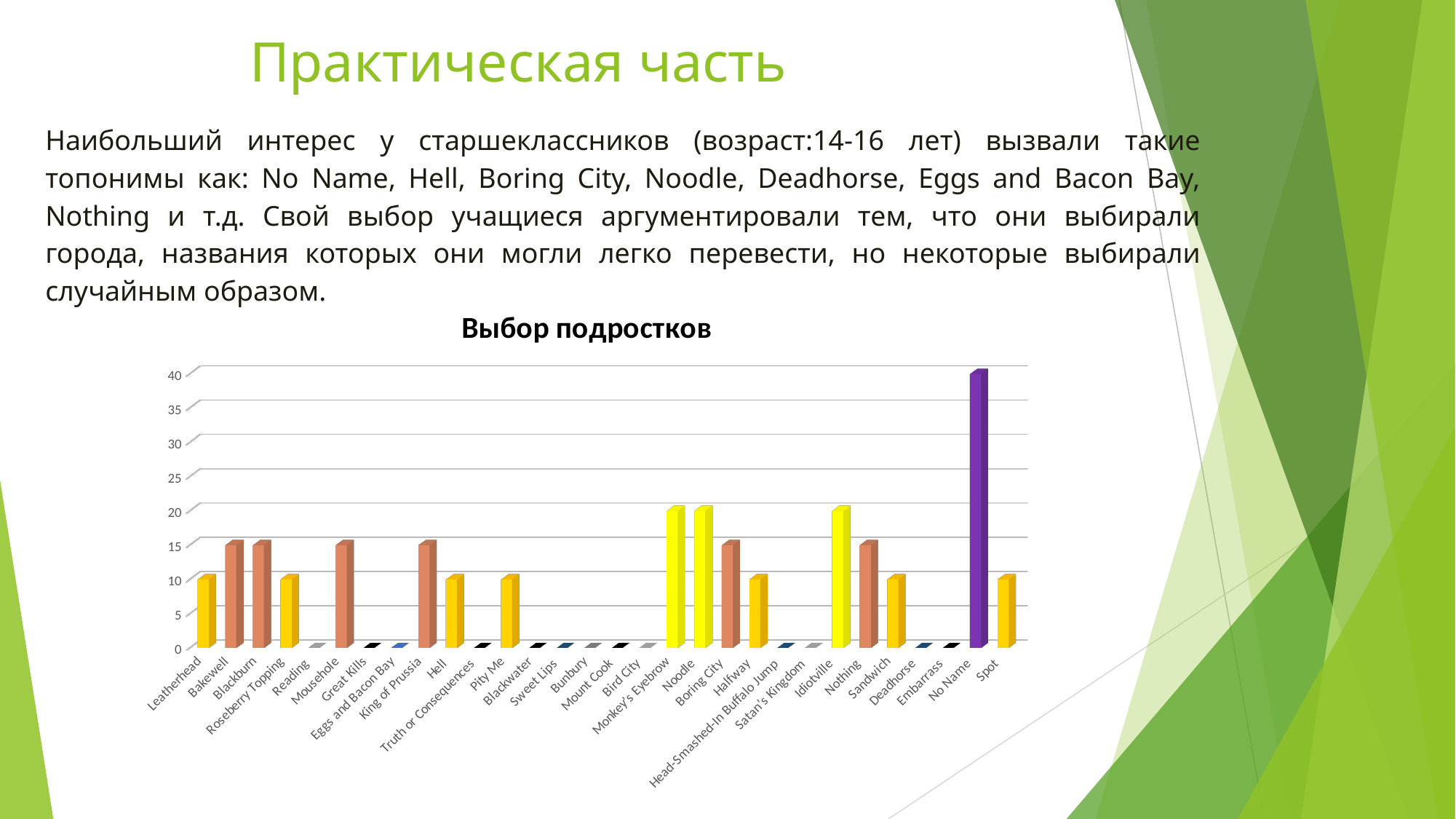
What value does the bar for Hell reach? 10 Is the value for Bakewell greater or less than 10? greater Which toponym has the highest value in the chart? No Name What is the title of the chart? Выбор подростков What kind of chart is shown on the slide? bar chart What value does the bar for No Name reach? 40 What value does the bar for Noodle reach? 20 What value does the bar for Boring City reach? 15 Is the value for Sandwich greater or less than 15? less What is the difference between the values for No Name and Idiotville? 20 How many toponyms (categories) are listed along the x axis? 30 Which is larger, the value for Noodle or the value for Boring City? Noodle